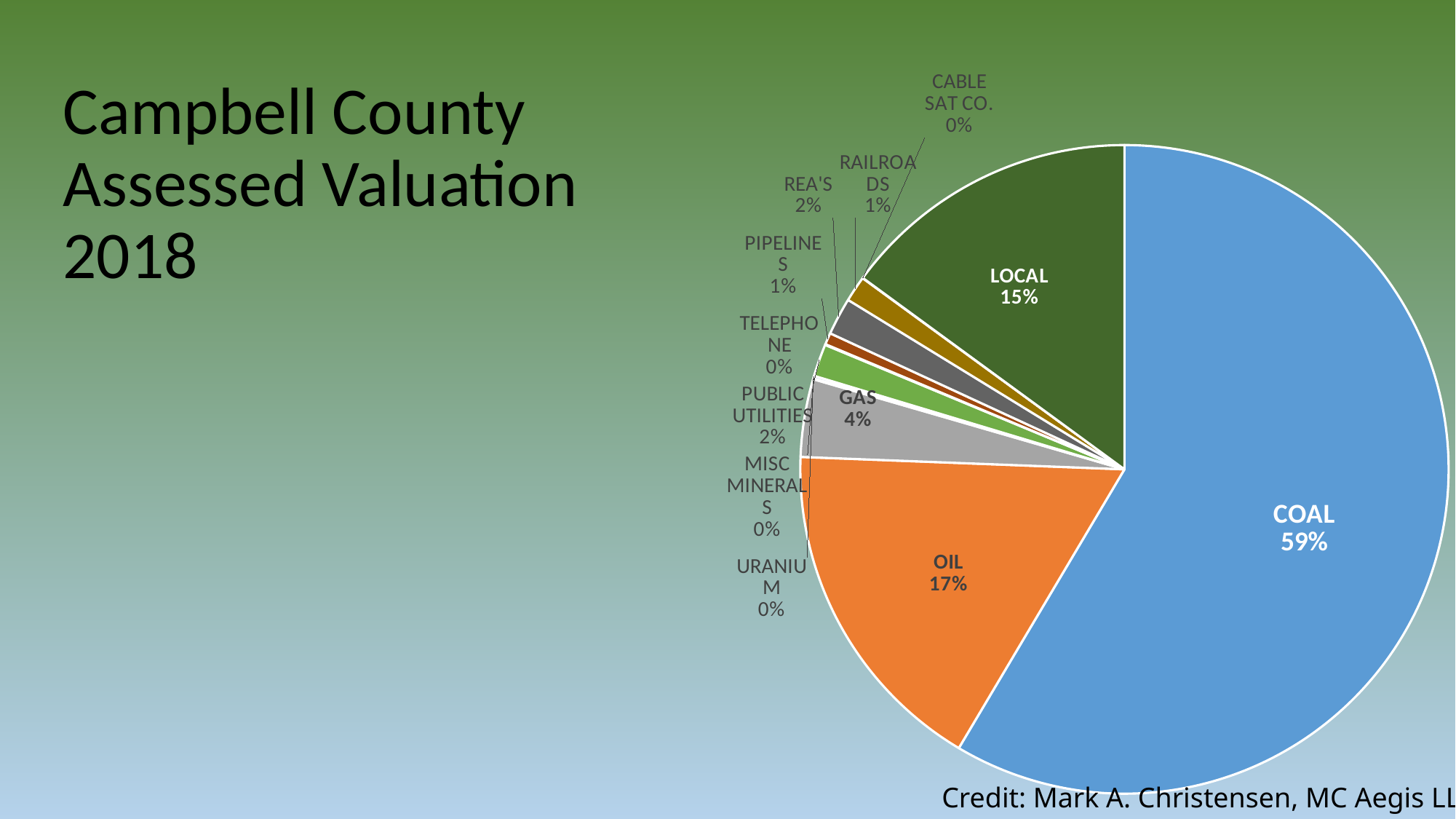
Which is larger, the OIL slice or the LOCAL slice? OIL What share of the pie does LOCAL represent? 15% What kind of chart is shown on the slide? pie chart What share of the pie does GAS represent? 4% What share of the pie does OIL represent? 17% Which category has the largest slice of the pie? COAL What percentage is shown for PUBLIC UTILITIES? 2% What is the difference in percentage points between COAL and OIL? 42 How many categories are labelled on the pie chart? 12 What is the title of the slide containing the pie chart? Campbell County Assessed Valuation 2018 What percentage is shown for PIPELINES? 1%